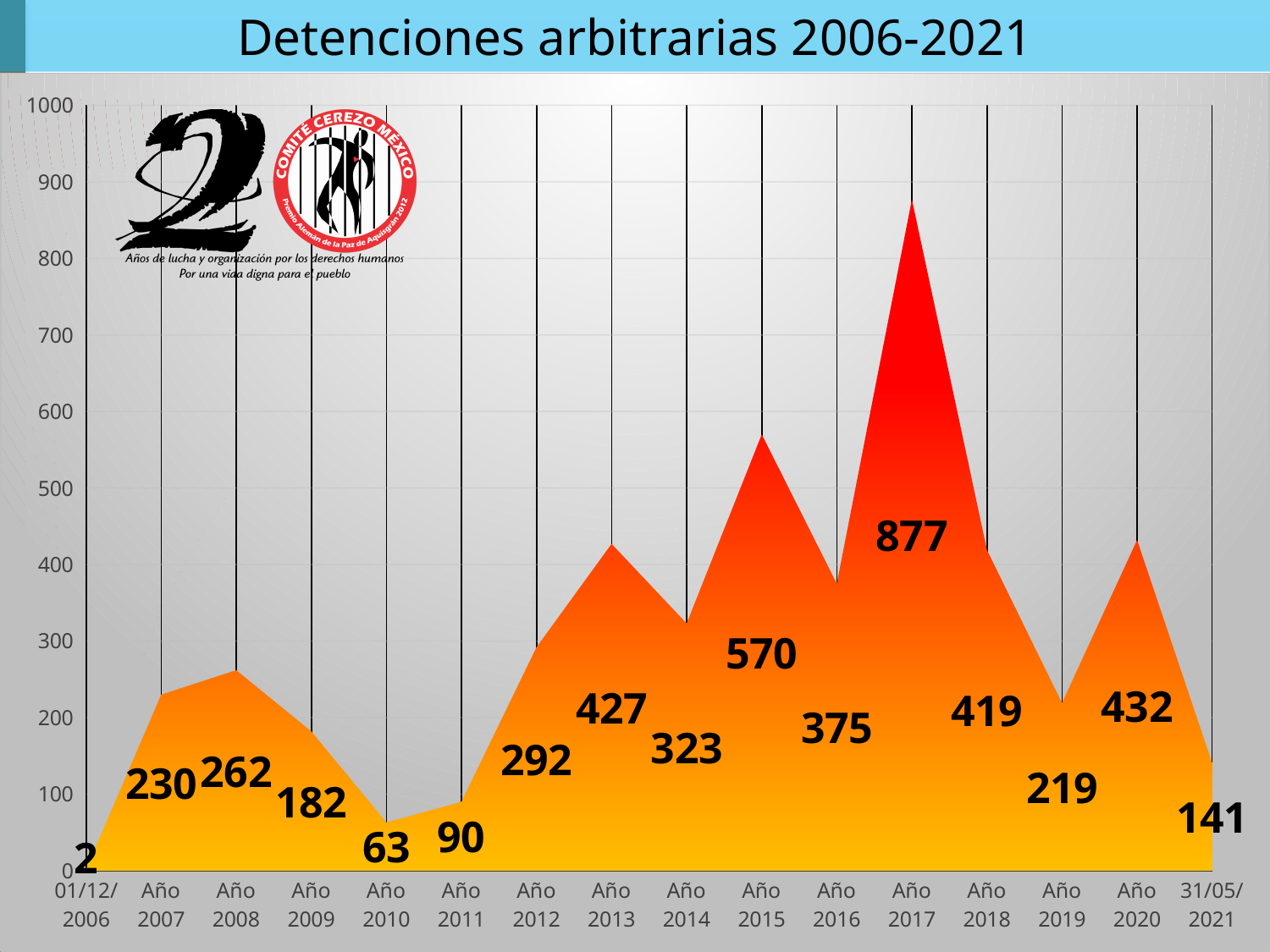
Which year has the highest number of arbitrary detentions? Año 2017 Which is larger, the value for Año 2013 or the value for Año 2014? Año 2013 Which point on the chart has the lowest value? 01/12/2006 What is the value for Año 2010? 63 How many data points are plotted on the chart? 16 What is the value for Año 2017? 877 Is the value for Año 2017 greater or less than 800? greater What kind of chart is shown on the slide? Area chart What is the title of the chart? Detenciones arbitrarias 2006-2021 What is the difference between the values for Año 2020 and Año 2019? 213 What is the value for 31/05/2021? 141 What is the difference between the values for Año 2017 and Año 2015? 307